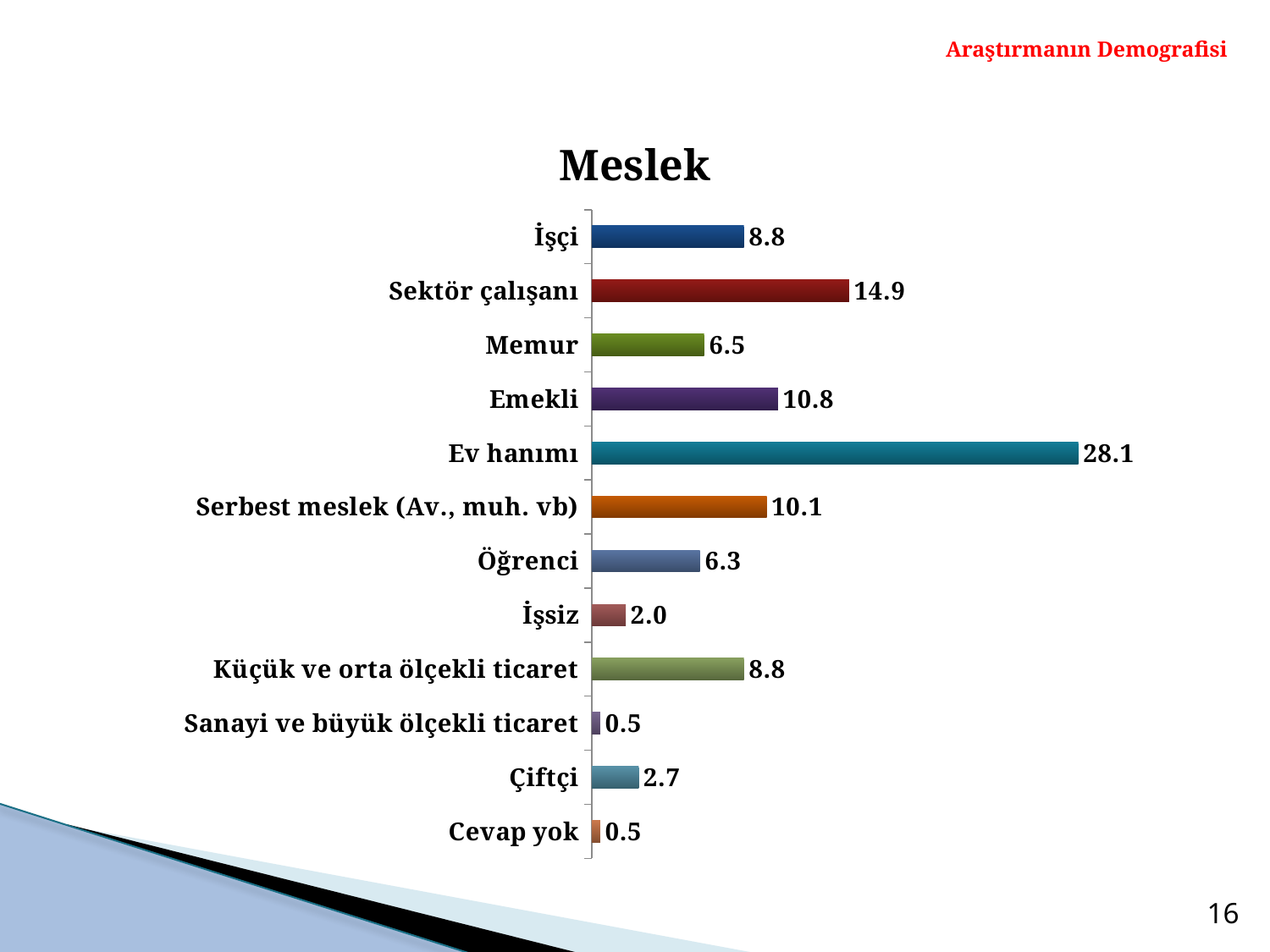
Which is larger, the value for Emekli or the value for İşçi? Emekli Which is larger, the value for Öğrenci or the value for İşsiz? Öğrenci What kind of chart is shown on the slide? Bar chart What is the difference between the values for Emekli and Memur? 4.3 What is the value for Serbest meslek (Av., muh. vb)? 10.1 Which category has the highest value? Ev hanımı What is the value for Ev hanımı? 28.1 What is the value for Sektör çalışanı? 14.9 How many categories are shown in the chart? 12 What is the value for Çiftçi? 2.7 What is the difference between the values for Ev hanımı and Sektör çalışanı? 13.2 What is the title of the chart? Meslek